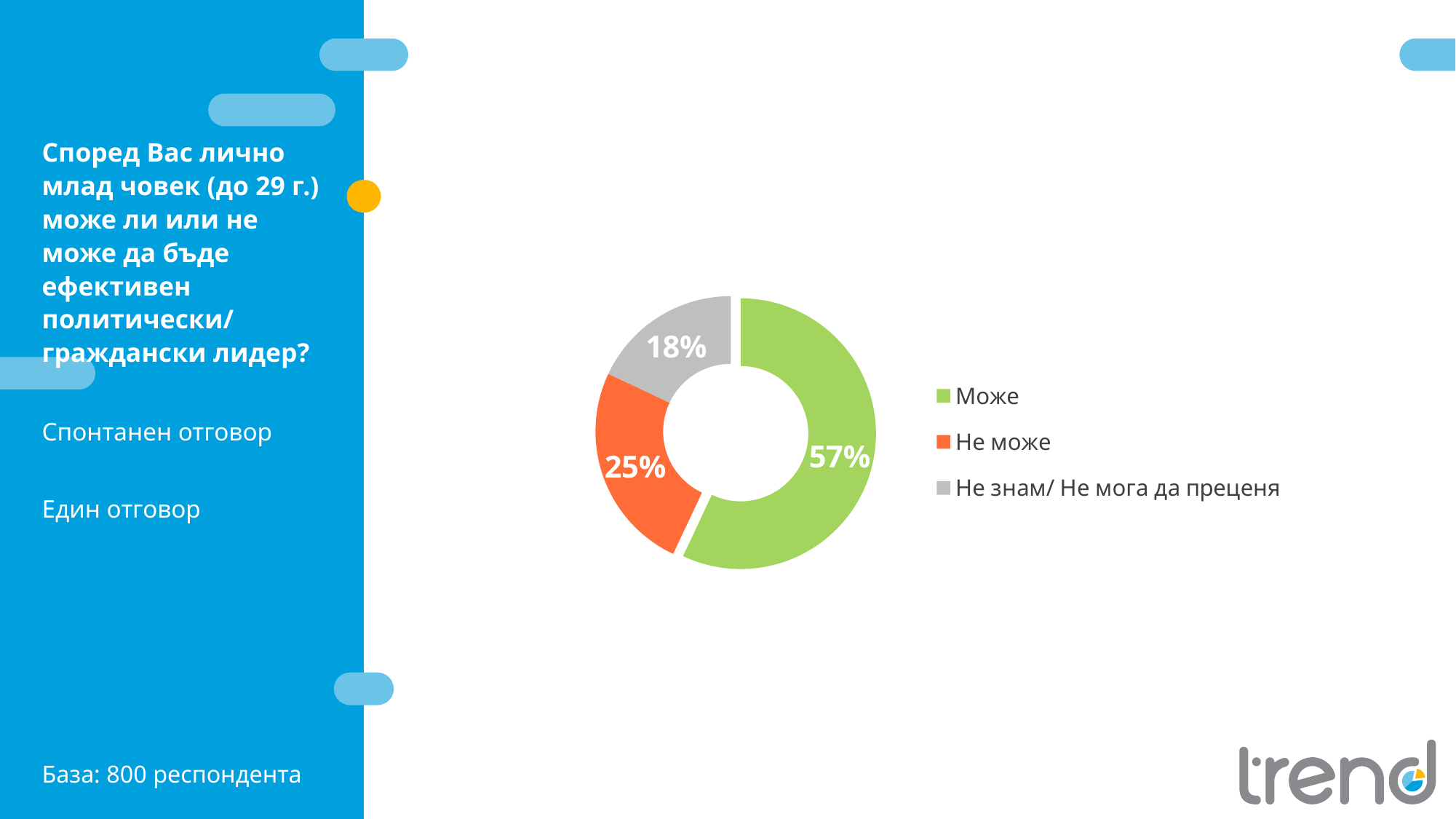
What percentage of respondents answered "Не знам/ Не мога да преценя"? 18% Which answer category has the largest share? Може Which answer category has the smallest share? Не знам/ Не мога да преценя How many answer categories are shown in the chart? 3 What percentage of respondents answered "Не може"? 25% What kind of chart is shown on the slide? Doughnut (pie) chart What percentage of respondents answered "Може"? 57% Which is larger, the share for "Не може" or the share for "Не знам/ Не мога да преценя"? Не може What is the difference in percentage points between "Не може" and "Не знам/ Не мога да преценя"? 7 What is the difference in percentage points between "Може" and "Не може"? 32 What colour represents the "Не може" category? Orange How many respondents form the base for this chart? 800